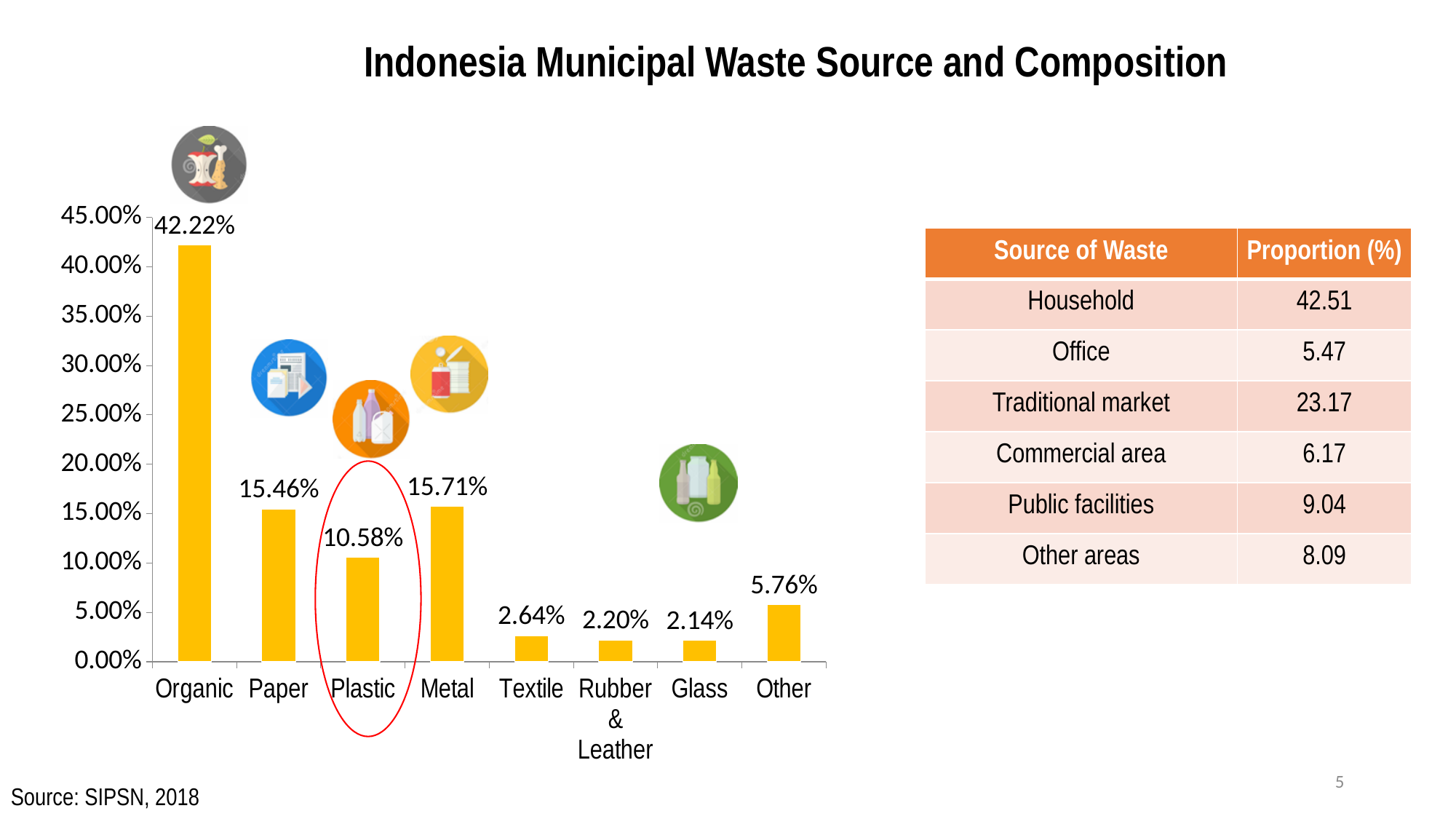
What is the value for Plastic in the bar chart? 10.58% How many categories are shown in the bar chart? 8 Which category has the highest value in the bar chart? Organic What is the difference between the values for Organic and Plastic in the bar chart? 31.64% What is the value for Organic in the bar chart? 42.22% What is the difference between the values for Metal and Paper in the bar chart? 0.25% What kind of chart is shown on the slide? bar chart Which is larger in the bar chart, the value for Other or the value for Textile? Other Is the value for Paper in the bar chart greater or less than 20.00%? less Which category has the lowest value in the bar chart? Glass Which category in the bar chart is circled in red? Plastic What is the value for Rubber & Leather in the bar chart? 2.20%